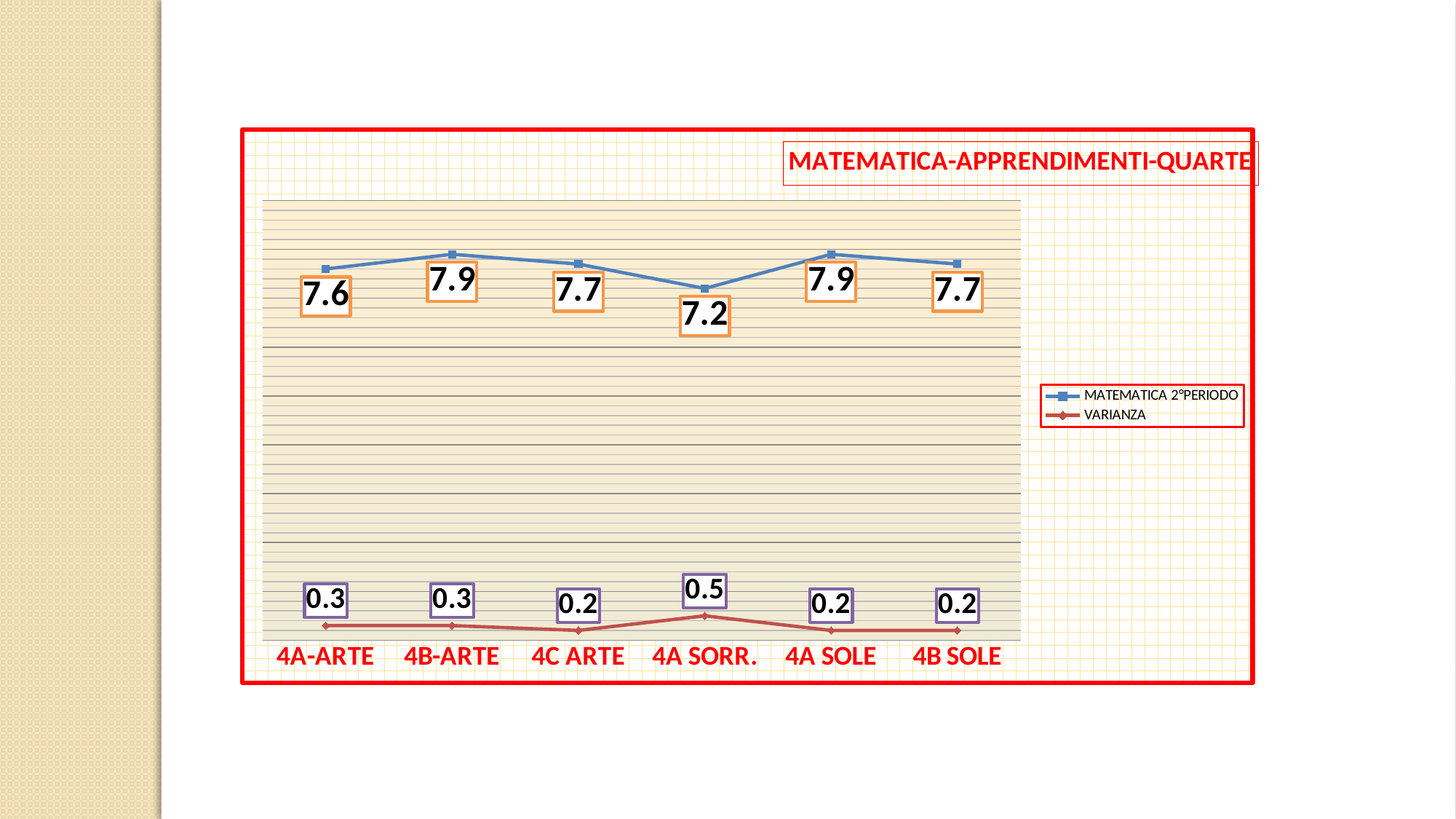
What is the difference between the MATEMATICA 2°PERIODO values for 4B-ARTE and 4A SORR.? 0.7 Which is larger, the MATEMATICA 2°PERIODO value for 4C ARTE or for 4A SOLE? 4A SOLE What is the VARIANZA value for 4B SOLE? 0.2 What kind of chart is shown? line chart How many series does the legend list? 2 How many categories are shown on the x axis? 6 Which category has the lowest MATEMATICA 2°PERIODO value? 4A SORR. What is the MATEMATICA 2°PERIODO value for 4A SORR.? 7.2 Which category has the highest VARIANZA value? 4A SORR. What is the VARIANZA value for 4A SORR.? 0.5 What is the title of the chart? MATEMATICA-APPRENDIMENTI-QUARTE What is the MATEMATICA 2°PERIODO value for 4A-ARTE? 7.6